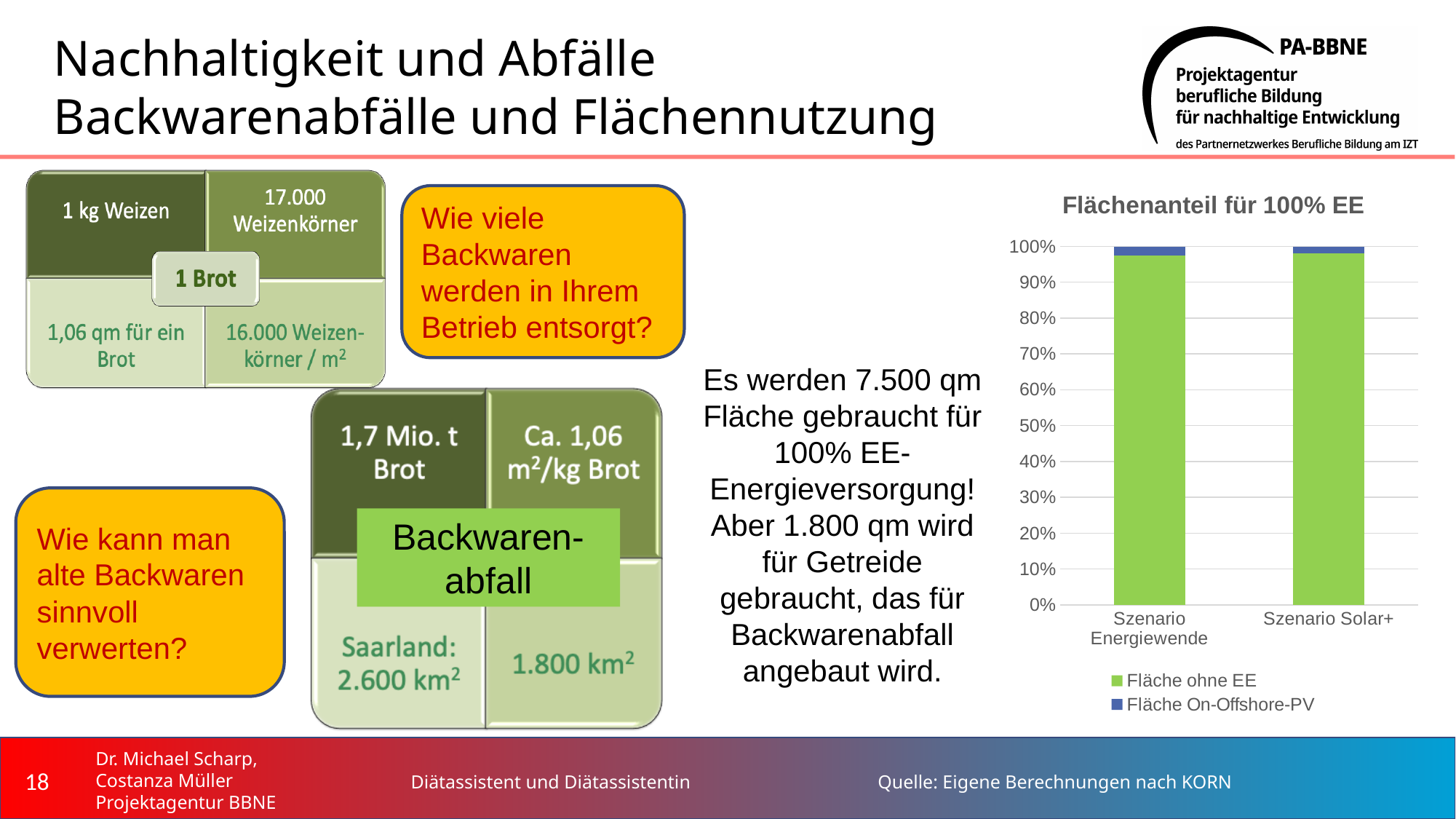
Is the value for Fläche On-Offshore-PV in Szenario Solar+ greater or less than 10%? less Which series is shown in green in the chart? Fläche ohne EE What kind of chart is shown on the slide? stacked bar chart Is the value for Fläche ohne EE in Szenario Energiewende greater or less than 90%? greater In Szenario Solar+, which series has the smaller share: Fläche ohne EE or Fläche On-Offshore-PV? Fläche On-Offshore-PV How many series does the chart's legend list? 2 How many scenarios (categories) are shown on the x axis of the chart? 2 In Szenario Energiewende, which series has the larger share: Fläche ohne EE or Fläche On-Offshore-PV? Fläche ohne EE Is the value for Fläche ohne EE in Szenario Solar+ greater or less than 90%? greater What is the highest value shown on the chart's y axis? 100% What is the title of the chart on the slide? Flächenanteil für 100% EE